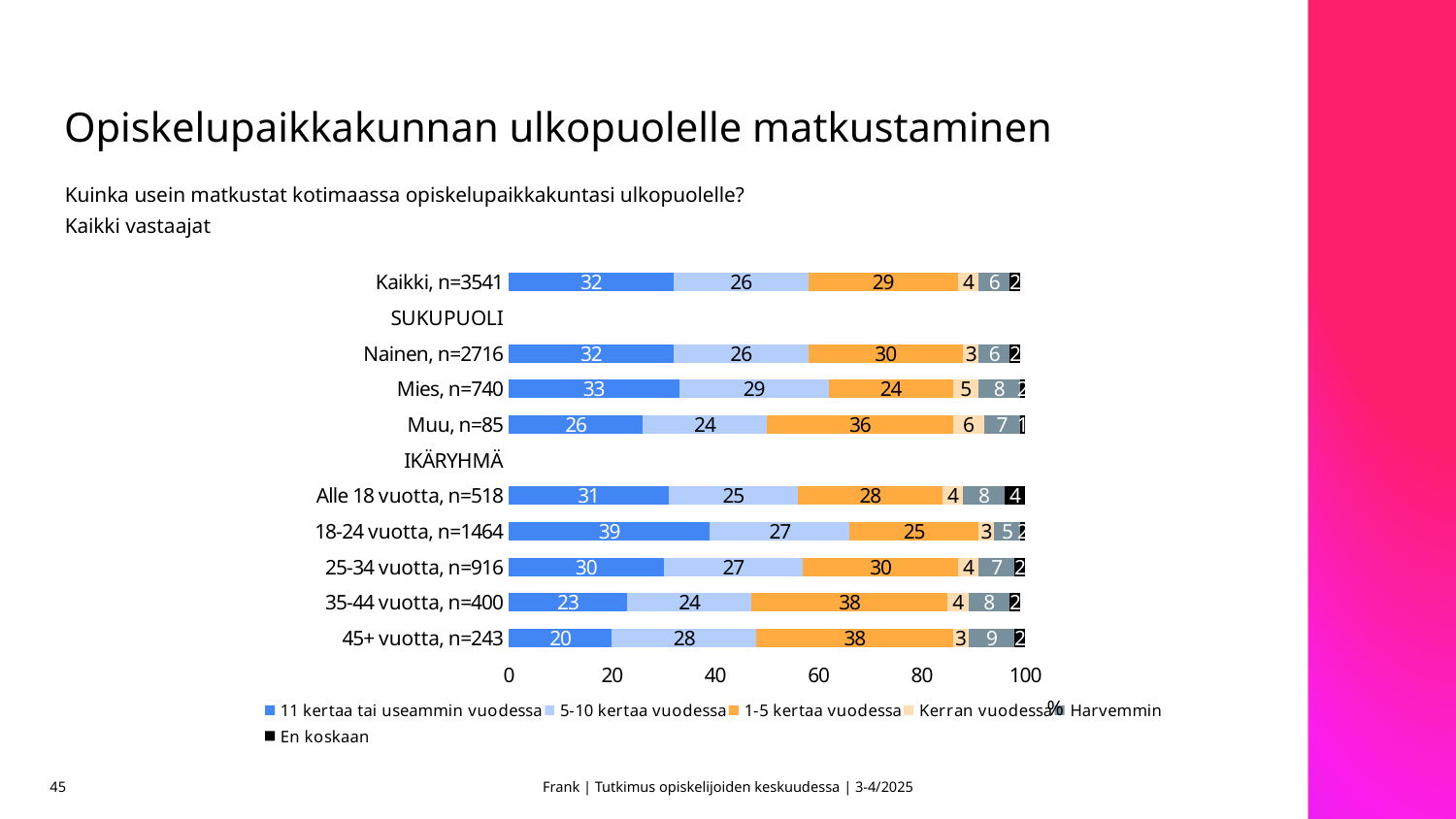
How many series does the legend list? 6 What is the value for '1-5 kertaa vuodessa' for 35-44 vuotta, n=400? 38 What kind of chart is shown on the slide? Stacked bar chart Which has a larger '1-5 kertaa vuodessa' value: Muu, n=85 or Mies, n=740? Muu, n=85 What is the value for '11 kertaa tai useammin vuodessa' for Kaikki, n=3541? 32 Which group has the highest value for '11 kertaa tai useammin vuodessa'? 18-24 vuotta, n=1464 How many respondent groups (bars) are plotted in the chart? 9 What is the value for '5-10 kertaa vuodessa' for Mies, n=740? 29 What is the difference between the '11 kertaa tai useammin vuodessa' values for 18-24 vuotta, n=1464 and 45+ vuotta, n=243? 19 What is the title of the slide containing the chart? Opiskelupaikkakunnan ulkopuolelle matkustaminen Which group has the lowest value for '11 kertaa tai useammin vuodessa'? 45+ vuotta, n=243 What is the 'Harvemmin' value for 45+ vuotta, n=243? 9